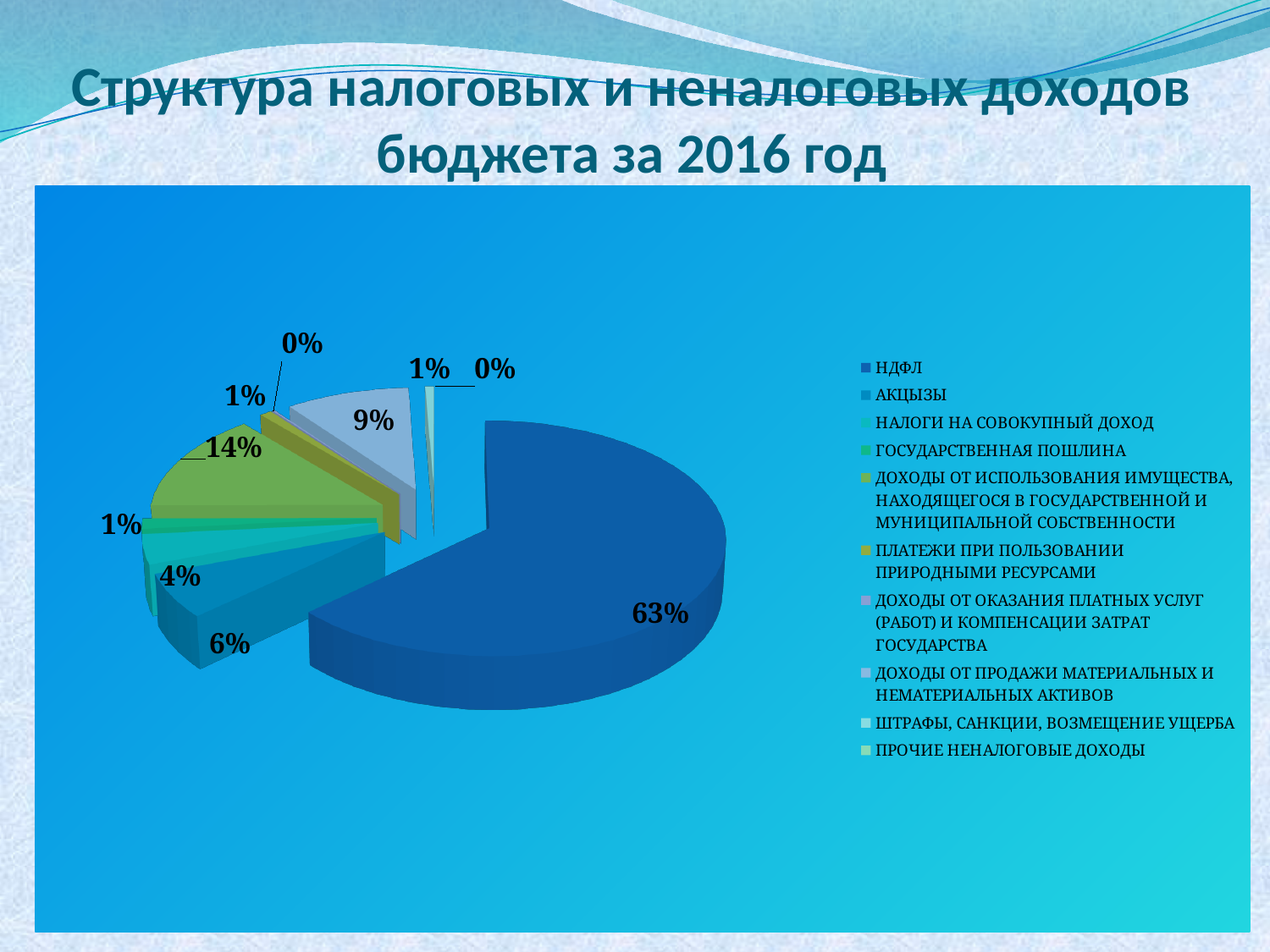
What share is shown for ДОХОДЫ ОТ ПРОДАЖИ МАТЕРИАЛЬНЫХ И НЕМАТЕРИАЛЬНЫХ АКТИВОВ? 9% What share is shown for ДОХОДЫ ОТ ИСПОЛЬЗОВАНИЯ ИМУЩЕСТВА, НАХОДЯЩЕГОСЯ В ГОСУДАРСТВЕННОЙ И МУНИЦИПАЛЬНОЙ СОБСТВЕННОСТИ? 14% What share of the pie does НДФЛ account for? 63% By how many percentage points does the largest slice (63%) exceed the 14% slice? 49 How many entries does the legend list? 10 What is the second-largest percentage labelled on the pie? 14% Which is larger: the slice labelled 9% or the slice labelled 14%? 14% How many slices are labelled 0%? 2 What is the title of the chart on the slide? Структура налоговых и неналоговых доходов бюджета за 2016 год Which category has the largest share of the pie? НДФЛ What kind of chart is shown on the slide? pie chart